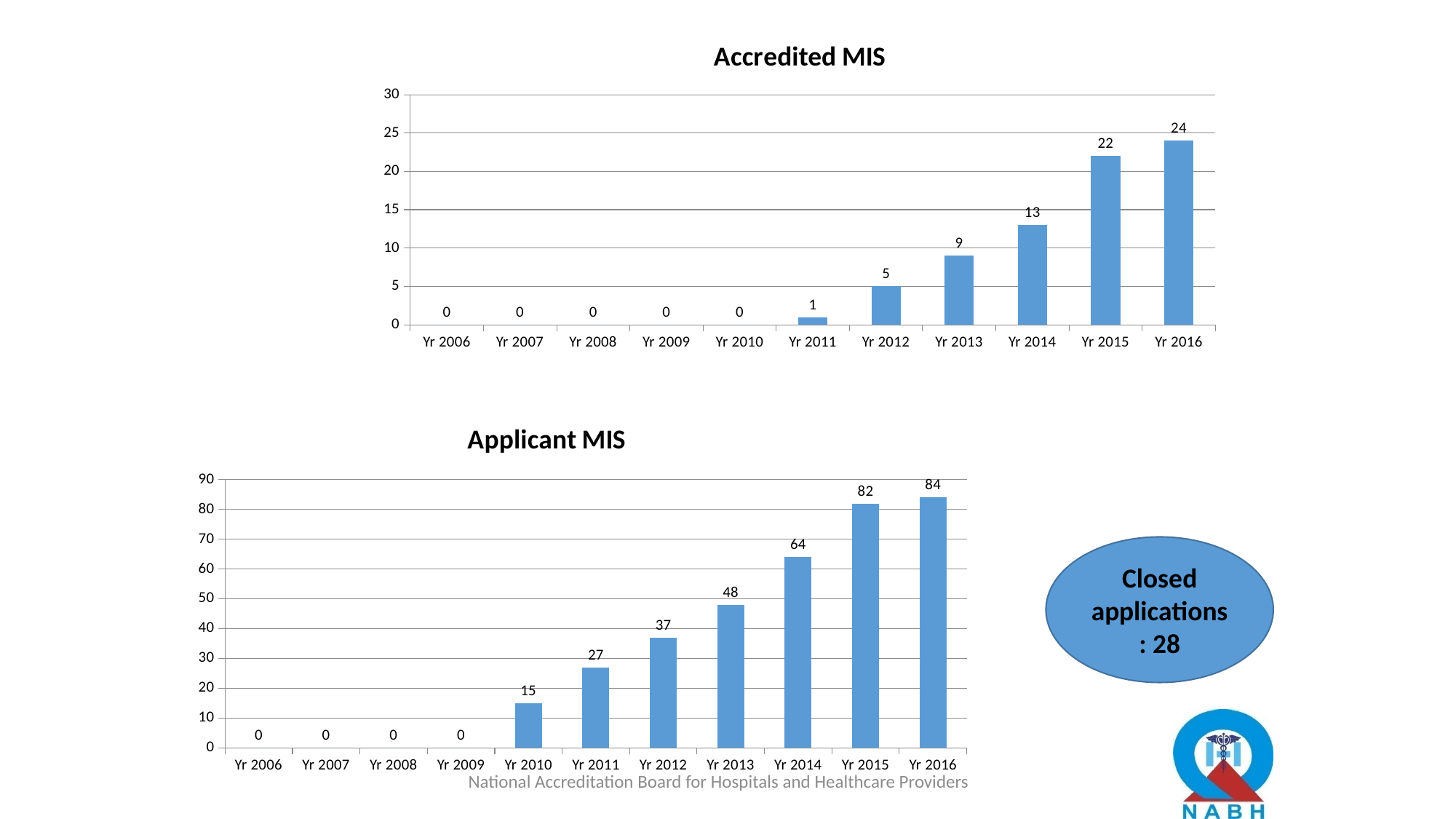
In the Accredited MIS chart, how many years are shown on the x axis? 11 In the Applicant MIS chart, what is the first year with a non-zero value? Yr 2010 What is the title of the top chart on the slide? Accredited MIS What kind of chart is the Applicant MIS chart? bar chart In the Accredited MIS chart, what is the difference between the values for Yr 2015 and Yr 2013? 13 In the Accredited MIS chart, do the values rise or fall from Yr 2011 to Yr 2016? rise In the Applicant MIS chart, which is larger, the value for Yr 2011 or the value for Yr 2010? Yr 2011 In the Applicant MIS chart, what is the value for Yr 2012? 37 In the Applicant MIS chart, which year has the highest value? Yr 2016 In the Accredited MIS chart, what is the value for Yr 2014? 13 In the Accredited MIS chart, which year has the highest value? Yr 2016 In the Applicant MIS chart, what is the difference between the values for Yr 2014 and Yr 2013? 16